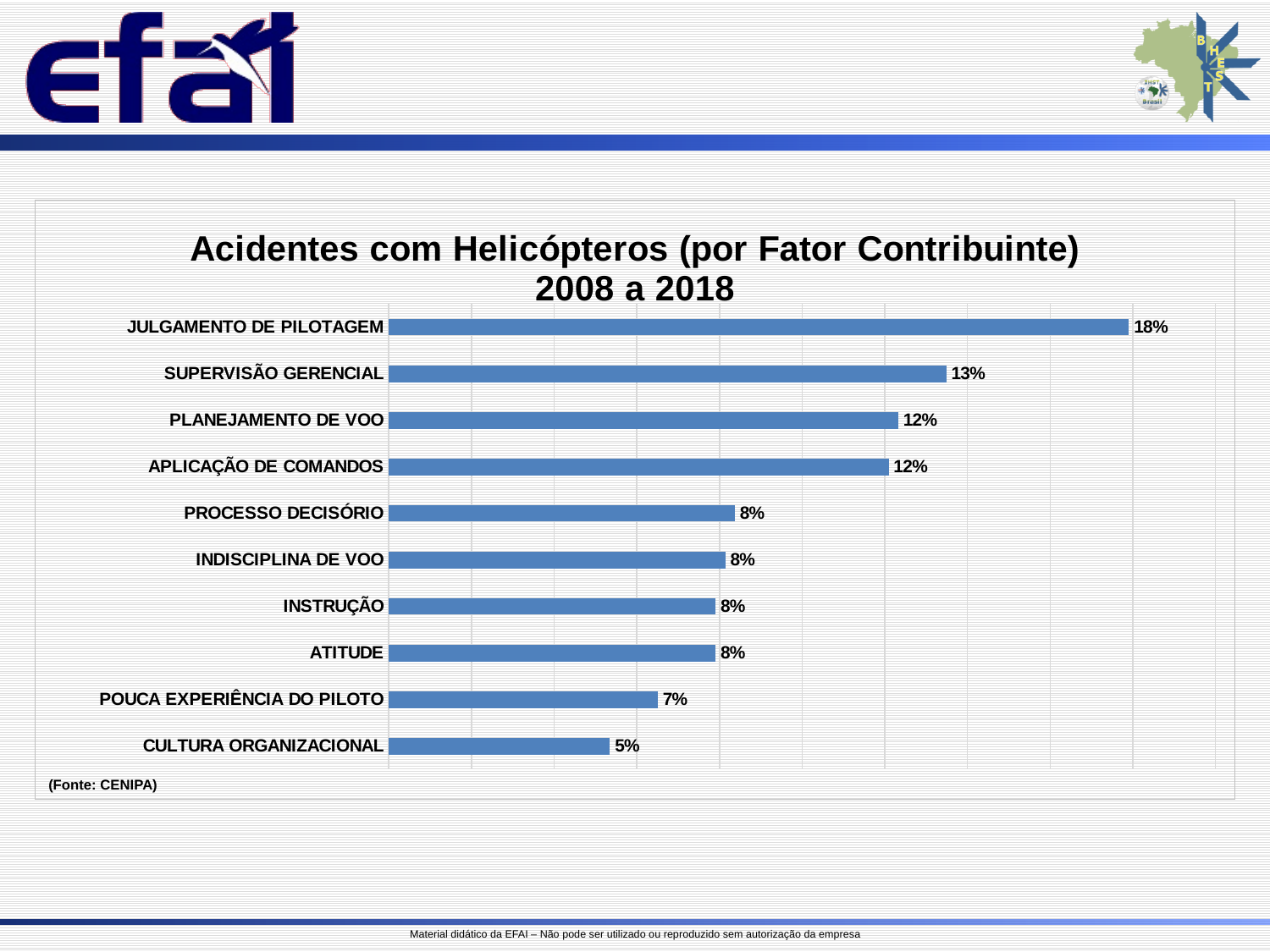
What is the value for POUCA EXPERIÊNCIA DO PILOTO? 7% What is the difference between the values for JULGAMENTO DE PILOTAGEM and SUPERVISÃO GERENCIAL? 5% Which category has the lowest value? CULTURA ORGANIZACIONAL What is the value for JULGAMENTO DE PILOTAGEM? 18% How many categories are shown in the chart? 10 Which category has the highest value? JULGAMENTO DE PILOTAGEM What is the difference between the values for PLANEJAMENTO DE VOO and CULTURA ORGANIZACIONAL? 7% What is the value for CULTURA ORGANIZACIONAL? 5% Which is larger, the value for SUPERVISÃO GERENCIAL or the value for PROCESSO DECISÓRIO? SUPERVISÃO GERENCIAL What kind of chart is shown on the slide? Bar chart What is the value for SUPERVISÃO GERENCIAL? 13% What is the title of the chart? Acidentes com Helicópteros (por Fator Contribuinte) 2008 a 2018